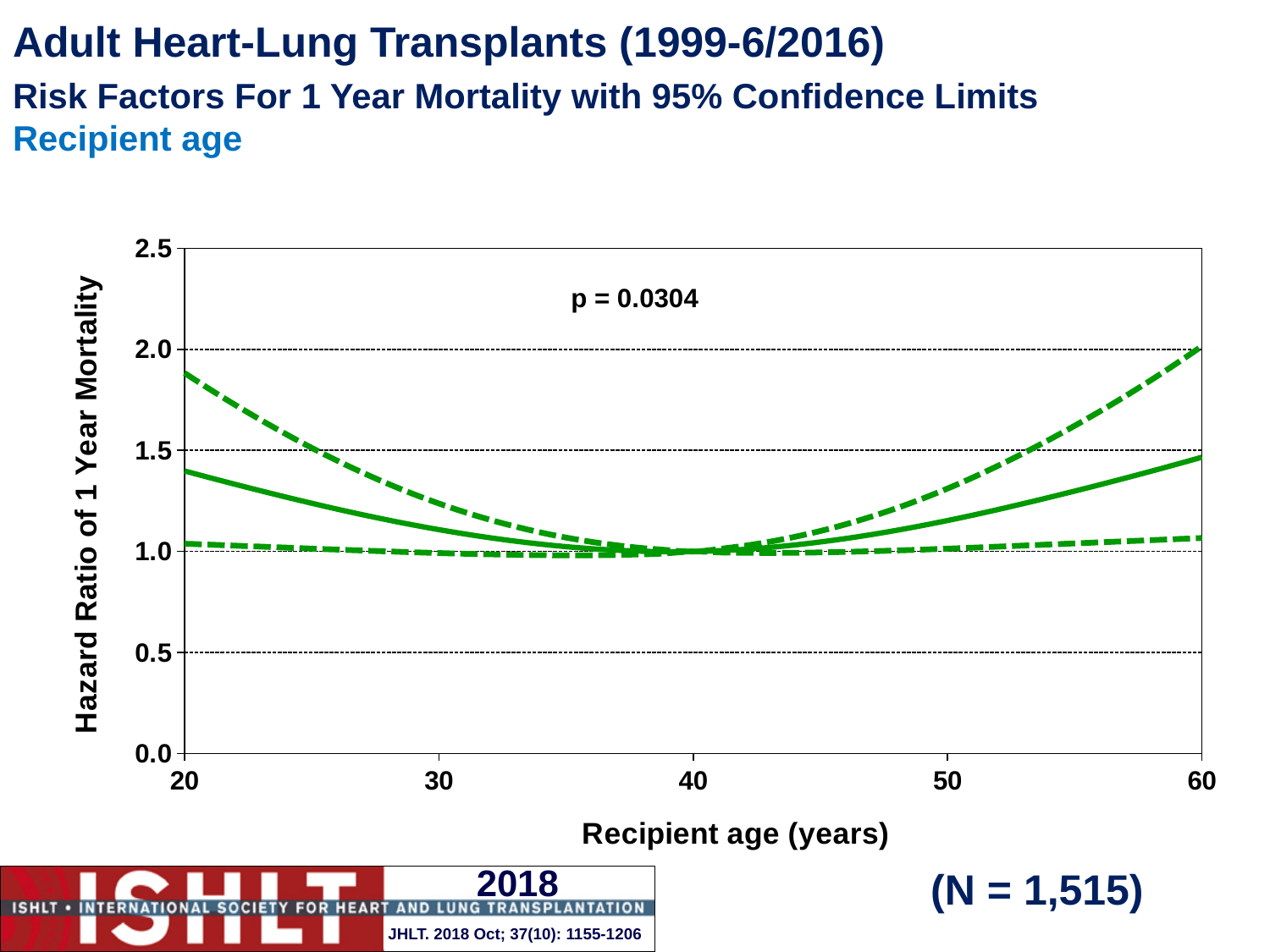
Is the hazard ratio (solid line) at recipient age 60 greater or less than 1.0? greater Is the hazard ratio (solid line) at recipient age 20 greater or less than 1.0? greater Is the upper confidence limit (upper dashed line) at recipient age 20 greater or less than 1.5? greater What sample size (N) is shown on the slide? N = 1,515 Does the hazard ratio (solid line) rise or fall as recipient age increases from 20 to 40 years? fall What kind of chart is shown on the slide? line chart How many lines are plotted on the chart? 3 Does the hazard ratio (solid line) rise or fall as recipient age increases from 40 to 60 years? rise Is the hazard ratio (solid line) higher at recipient age 20 or at recipient age 40? age 20 What p-value is printed on the chart? p = 0.0304